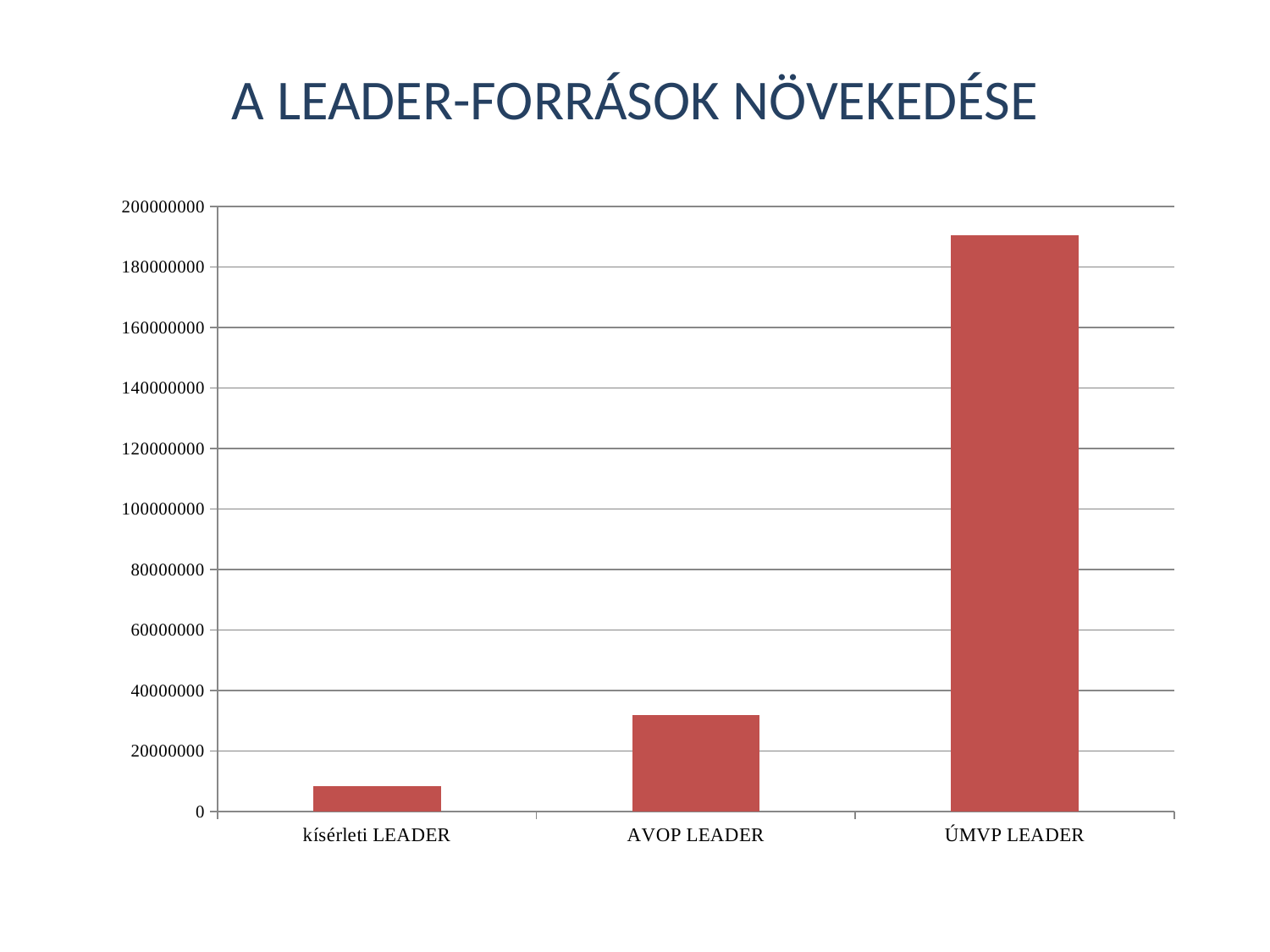
Is the value for AVOP LEADER greater or less than 40000000? less Is the value for kísérleti LEADER greater or less than 20000000? less What is the highest value shown on the vertical axis? 200000000 What is the title of the slide? A LEADER-FORRÁSOK NÖVEKEDÉSE Is the value for AVOP LEADER greater or less than 20000000? greater Which category has the highest value? ÚMVP LEADER How many categories are shown on the x axis? 3 Do the values rise or fall from left to right along the x axis? rise Which category has the lowest value? kísérleti LEADER What kind of chart is shown on the slide? bar chart Which is larger, the value for AVOP LEADER or the value for kísérleti LEADER? AVOP LEADER